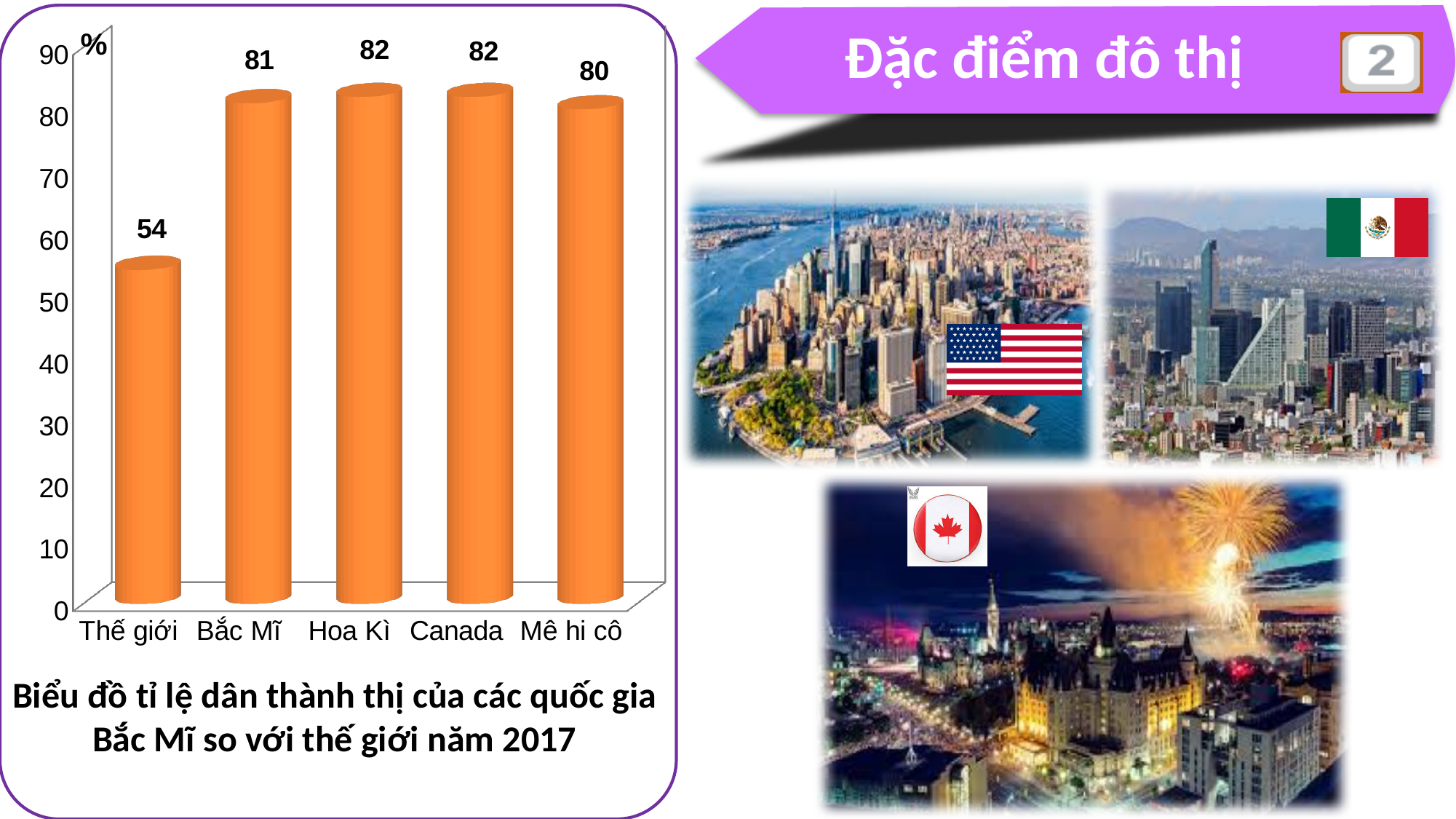
What is the difference between the values for Bắc Mĩ and Mê hi cô? 1 What is the value for Bắc Mĩ? 81 What kind of chart is shown on the slide? bar chart Is the value for Thế giới greater or less than 60? less What unit is shown at the top of the vertical axis? % How many categories are shown on the x axis? 5 What is the difference between the values for Canada and Thế giới? 28 Which category has the lowest value? Thế giới What is the value for Thế giới? 54 What is the value for Mê hi cô? 80 Which is larger, the value for Hoa Kì or the value for Mê hi cô? Hoa Kì What is the value for Hoa Kì? 82